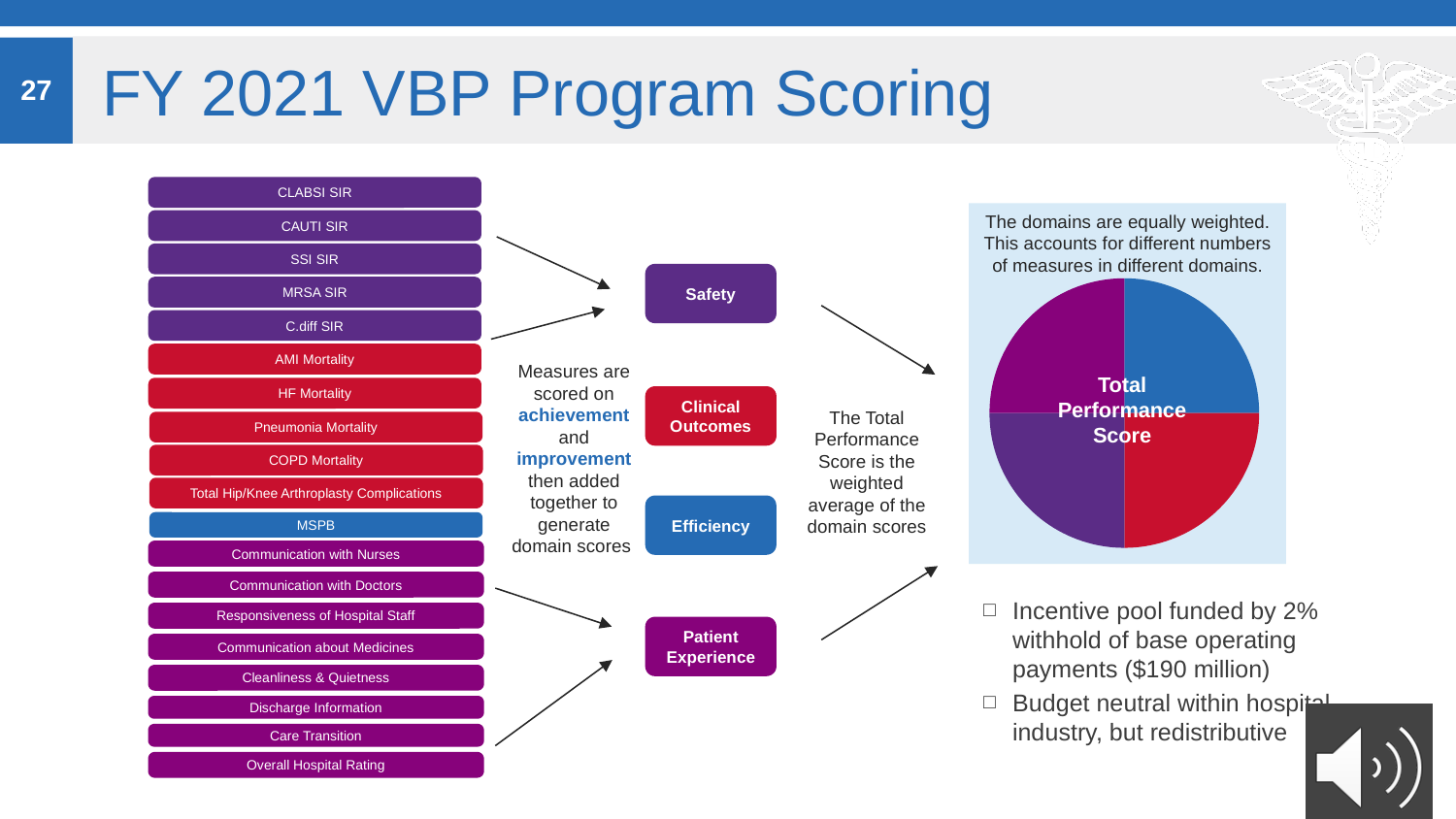
What colour is the top-right slice of the pie chart? Blue Are the four slices of the pie chart equal in size? Yes How many slices does the pie chart have? 4 What kind of chart is shown on the right side of the slide? Pie chart What text is printed in the centre of the pie chart? Total Performance Score